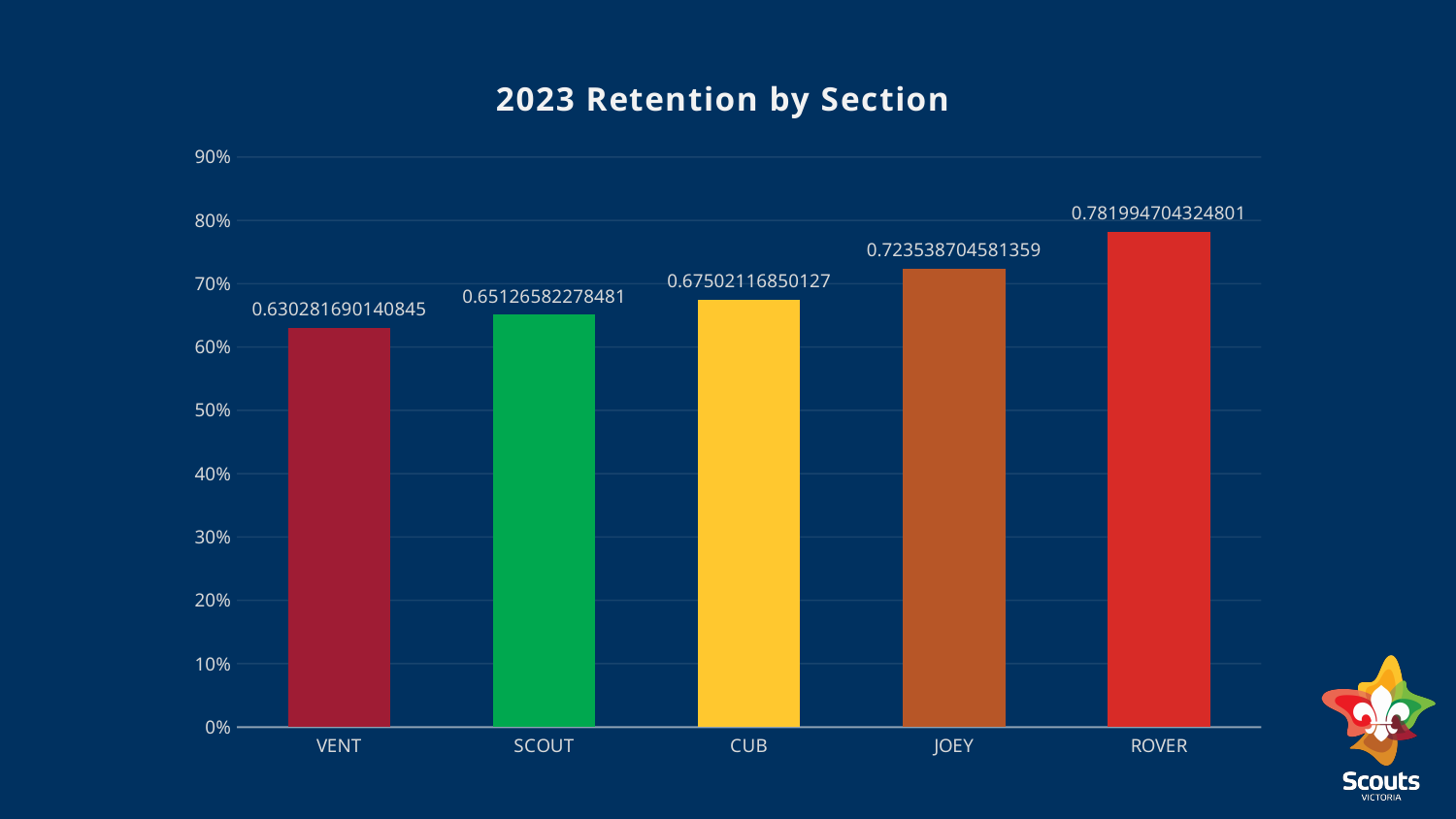
Which section has the lowest retention? VENT What is the data label shown for ROVER? 0.781994704324801 Which has higher retention, JOEY or SCOUT? JOEY What kind of chart is this? bar chart Is the value for JOEY greater or less than 70%? greater Which section has the highest retention? ROVER Is the value for ROVER greater or less than 80%? less What is the data label shown for VENT? 0.630281690140845 Do the retention values rise or fall from VENT to ROVER along the x axis? rise What is the data label shown for CUB? 0.67502116850127 What is the title of the chart? 2023 Retention by Section How many sections are shown on the chart? 5